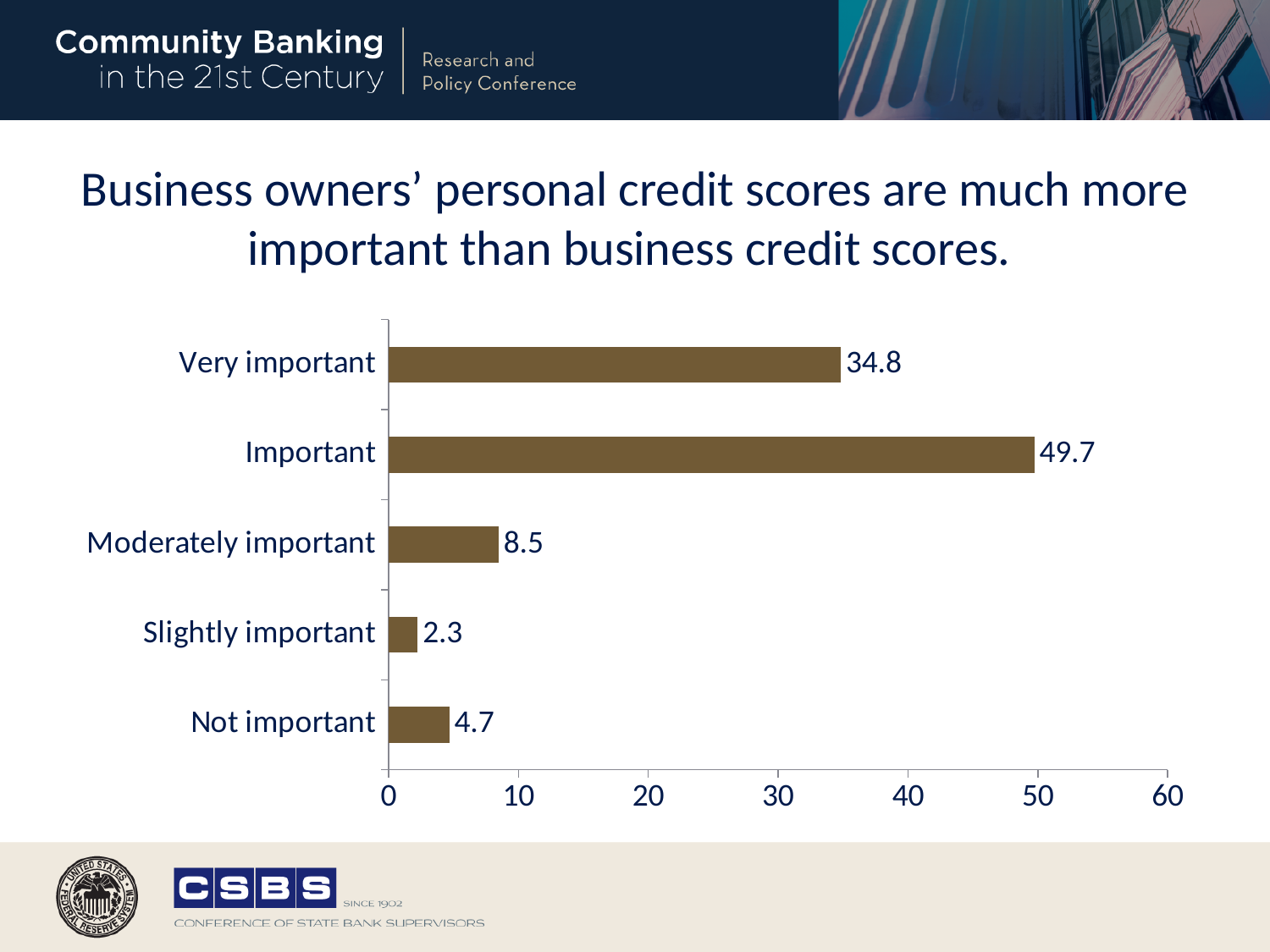
Which category has the highest value? Important Is the value for Very important greater or less than 30? greater What is the value for Very important? 34.8 What is the value for Slightly important? 2.3 Which category has the lowest value? Slightly important What is the value for Moderately important? 8.5 What kind of chart is shown on the slide? bar chart How many categories are shown in the chart? 5 What is the value for Not important? 4.7 What is the value for Important? 49.7 What is the difference between the values for Important and Very important? 14.9 Which is larger, the value for Not important or the value for Slightly important? Not important